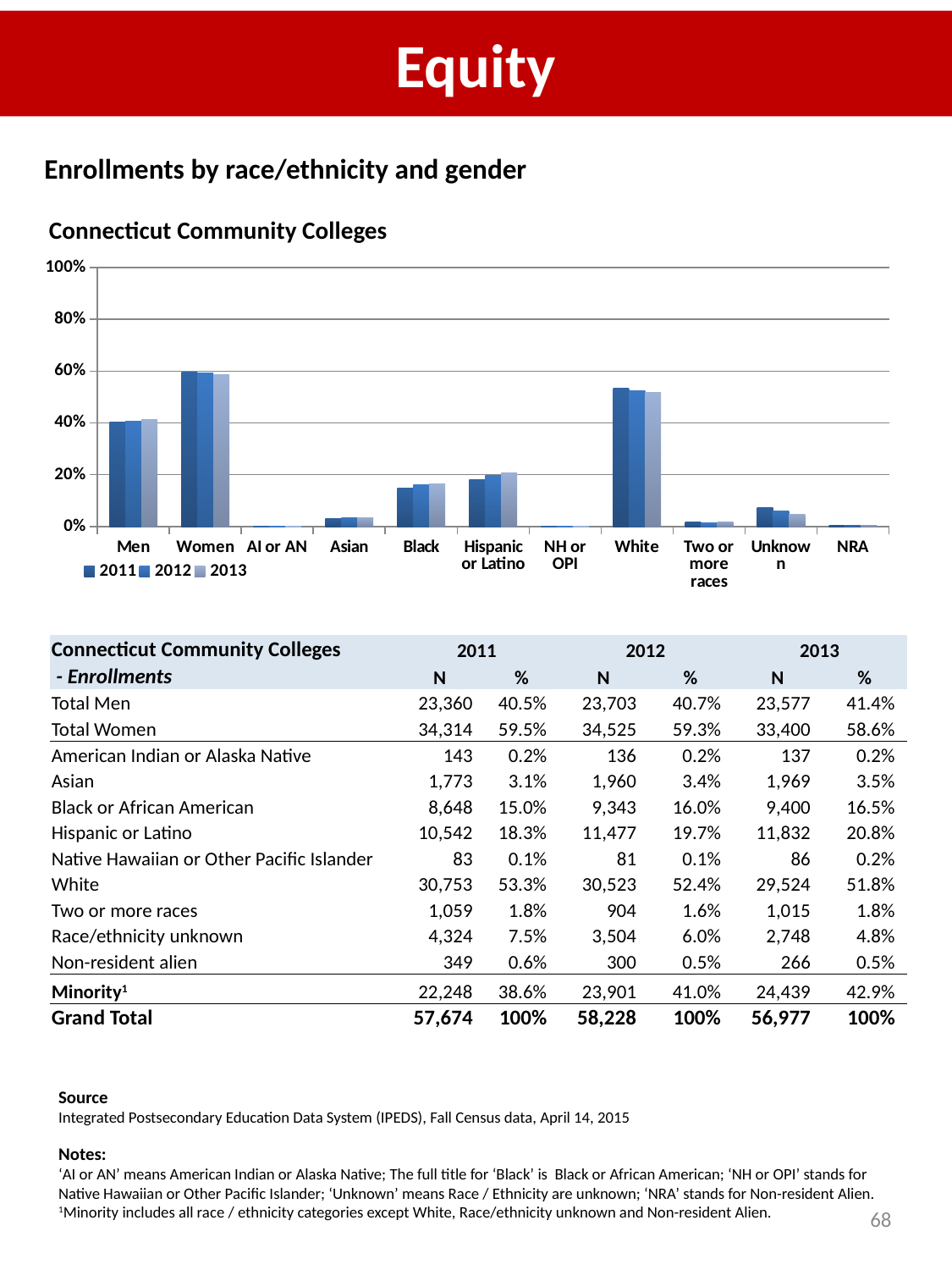
According to the table below the chart, what percentage of enrollments were Total Men in 2011? 40.5% How many categories are shown along the x axis of the chart? 11 Which category has the highest bar for 2011 in the chart? Women In 2013, which is larger in the chart: the value for Women or the value for Men? Women Is the 2011 value for Men greater or less than 20%? greater Is the 2013 value for White greater or less than 60%? less Is the 2011 value for Unknown greater or less than 20%? less How many series does the chart's legend list? 3 What kind of chart is shown on the slide? bar chart Do the bars for Unknown rise or fall from 2011 to 2013? fall Do the bars for Hispanic or Latino rise or fall from 2011 to 2013? rise What is the title shown above the chart? Connecticut Community Colleges